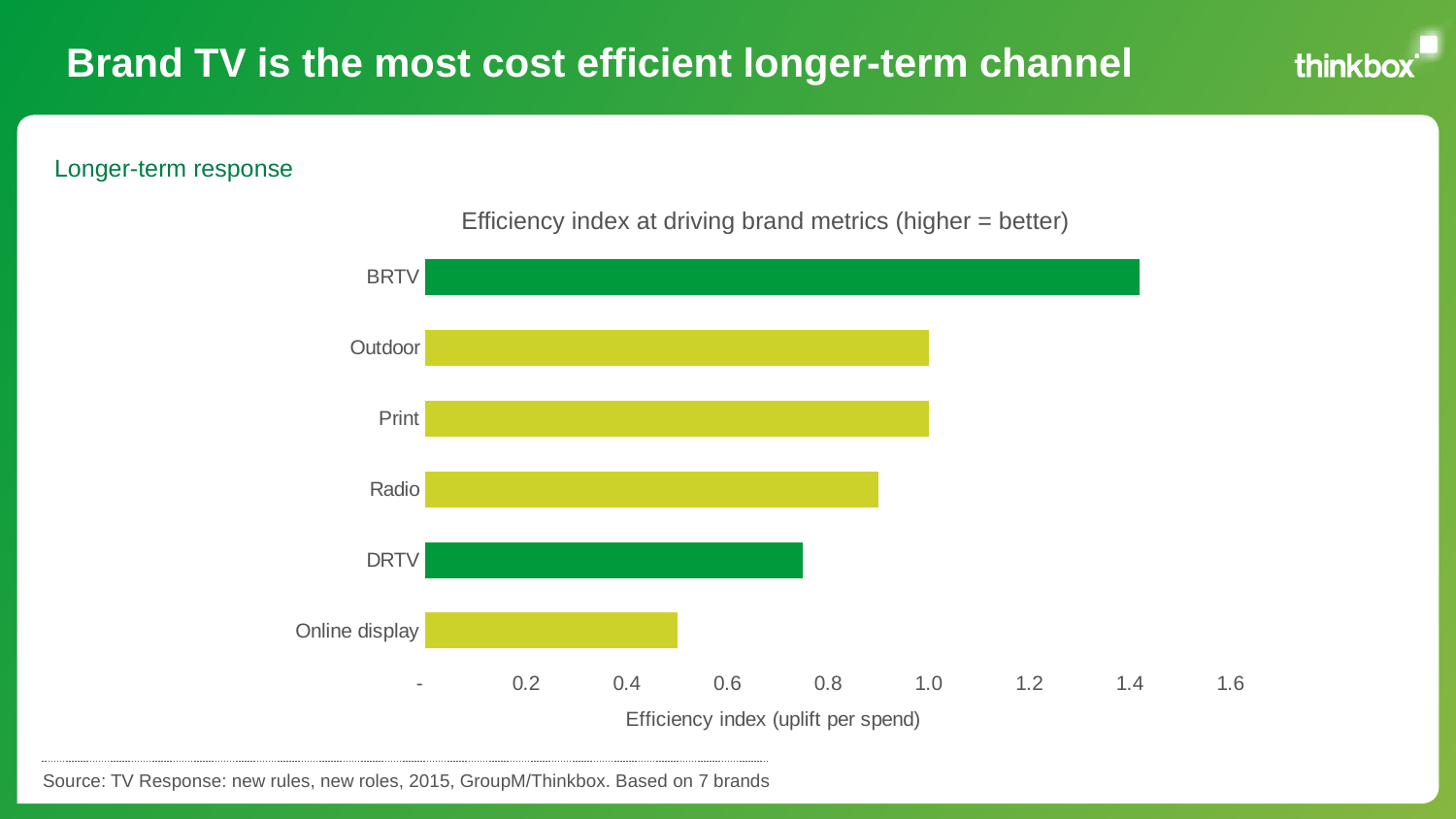
Is the efficiency index for Radio greater or less than 0.8? greater What is the label on the horizontal axis of the chart? Efficiency index (uplift per spend) Which has a higher efficiency index, Radio or Online display? Radio What is the title of the chart? Efficiency index at driving brand metrics (higher = better) Which channel has the highest efficiency index? BRTV Which has a higher efficiency index, BRTV or DRTV? BRTV How many channels are plotted in the chart? 6 What kind of chart is shown on the slide? bar chart Is the efficiency index for DRTV greater or less than 0.8? less Which channel has the lowest efficiency index? Online display Is the efficiency index for BRTV greater or less than 1.2? greater